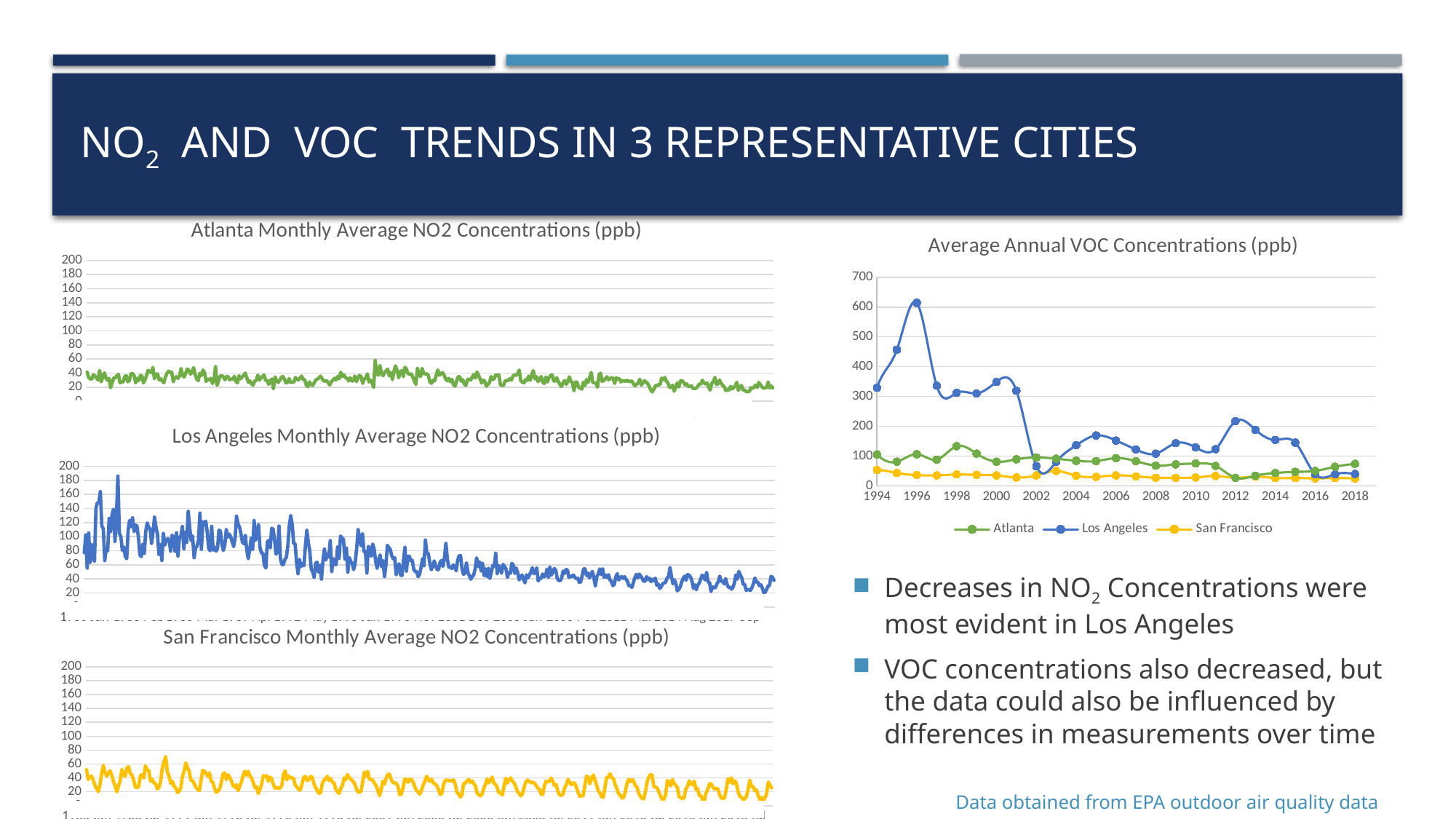
In the Atlanta Monthly Average NO2 Concentrations (ppb) chart, are the plotted values greater or less than 100? less In the Average Annual VOC Concentrations (ppb) chart, is the Los Angeles value for 1996 greater or less than 500? greater In the Average Annual VOC Concentrations (ppb) chart, what colour is the Los Angeles series? blue In the Average Annual VOC Concentrations (ppb) chart, is the San Francisco value for 1994 greater or less than 100? less In the Los Angeles Monthly Average NO2 Concentrations (ppb) chart, do the values generally rise or fall over time? fall What kind of chart is the Average Annual VOC Concentrations (ppb) chart? line chart In the Average Annual VOC Concentrations (ppb) chart, which city has the highest value in 1996? Los Angeles In the Average Annual VOC Concentrations (ppb) chart, which is larger in 1994, the Los Angeles value or the Atlanta value? Los Angeles How many series does the legend of the Average Annual VOC Concentrations (ppb) chart list? 3 In the Average Annual VOC Concentrations (ppb) chart, which city has the lowest value in 1994? San Francisco